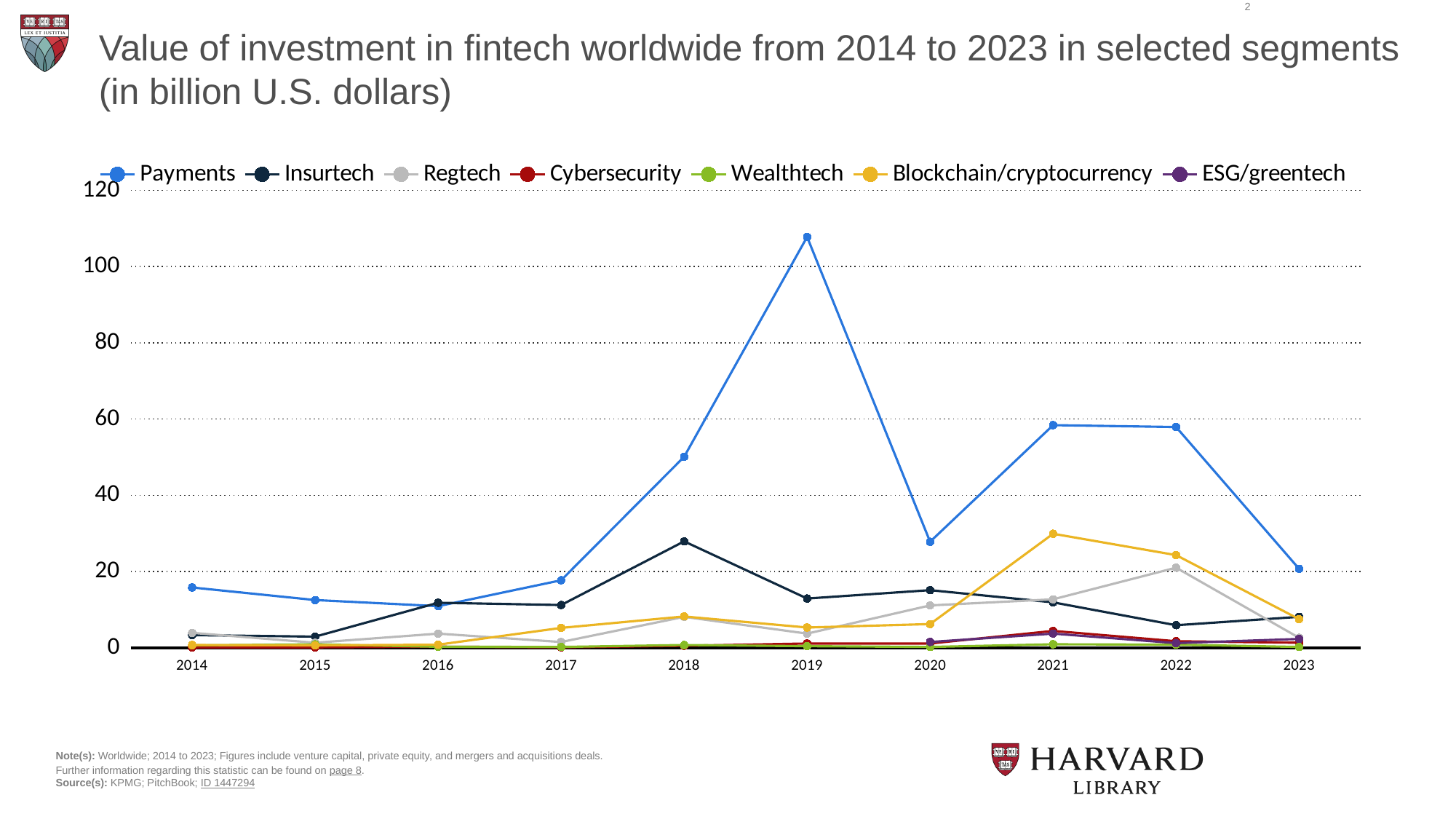
In 2018, which is larger: Insurtech or Regtech? Insurtech Does the Payments series rise or fall from 2021 to 2023? fall What kind of chart is shown on the slide? line chart Is the value for Payments in 2020 greater or less than 40? less Is the value for Insurtech in 2018 greater or less than 20? greater In which year does the Payments series reach its highest value? 2019 Is the value for Payments in 2019 greater or less than 100? greater In 2021, which is larger: Payments or Blockchain/cryptocurrency? Payments How many series does the legend list? 7 How many years are plotted along the x axis? 10 In which year does the Blockchain/cryptocurrency series reach its highest value? 2021